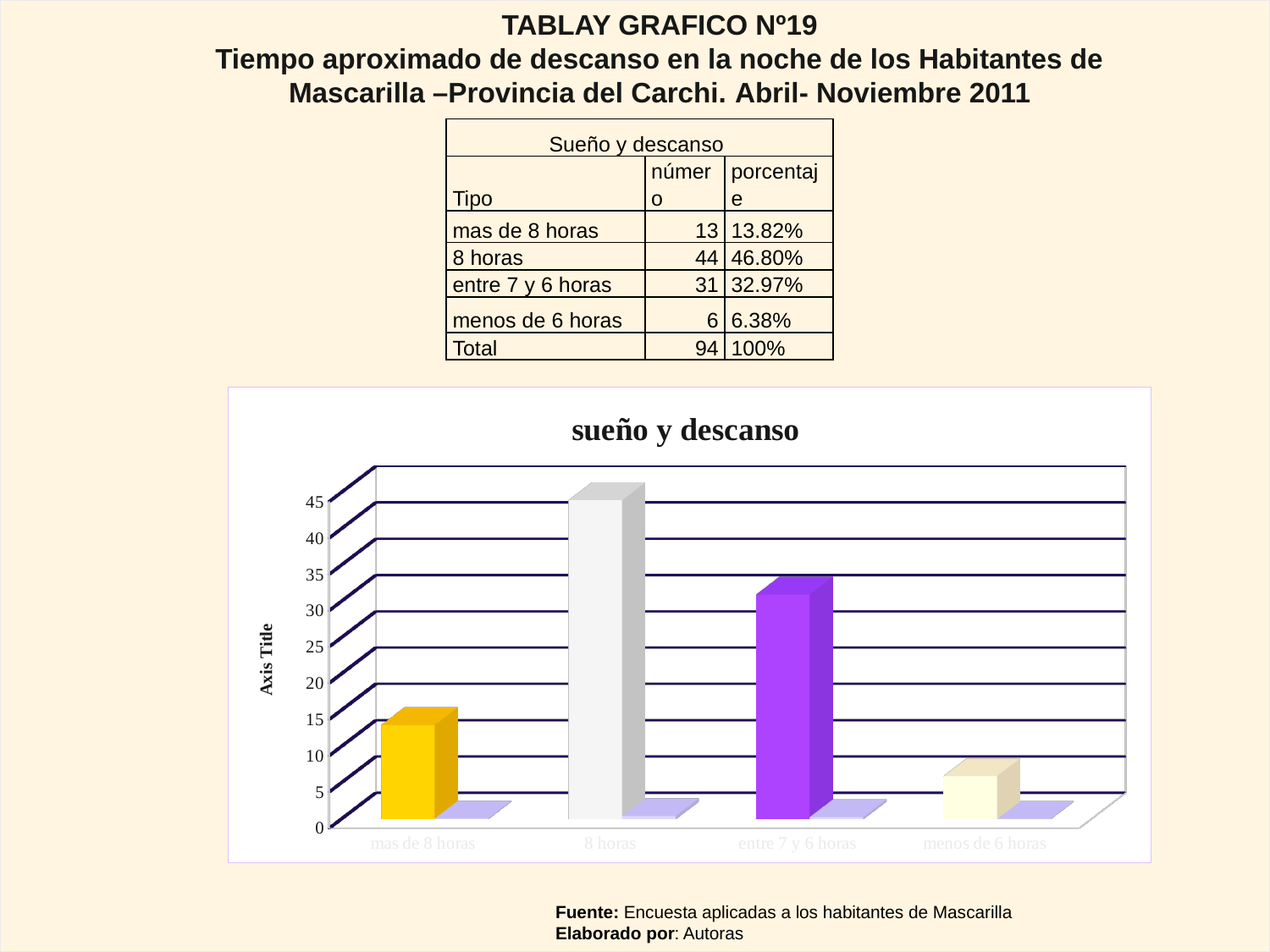
Which category has the highest bar in the chart? 8 horas What is the title of the chart? sueño y descanso Which is larger, the bar for 'mas de 8 horas' or the bar for 'entre 7 y 6 horas'? entre 7 y 6 horas Which category has the lowest bar in the chart? menos de 6 horas According to the table, what is the percentage for 'mas de 8 horas'? 13.82% According to the table, what is the number for 'entre 7 y 6 horas'? 31 Using the table values, what is the difference between the number for '8 horas' and the number for 'menos de 6 horas'? 38 Is the bar for 'menos de 6 horas' greater or less than 10? less How many categories are shown on the x axis of the chart? 4 What kind of chart is shown on the slide? bar chart Is the bar for 'entre 7 y 6 horas' greater or less than 25? greater According to the table, what is the number for '8 horas'? 44